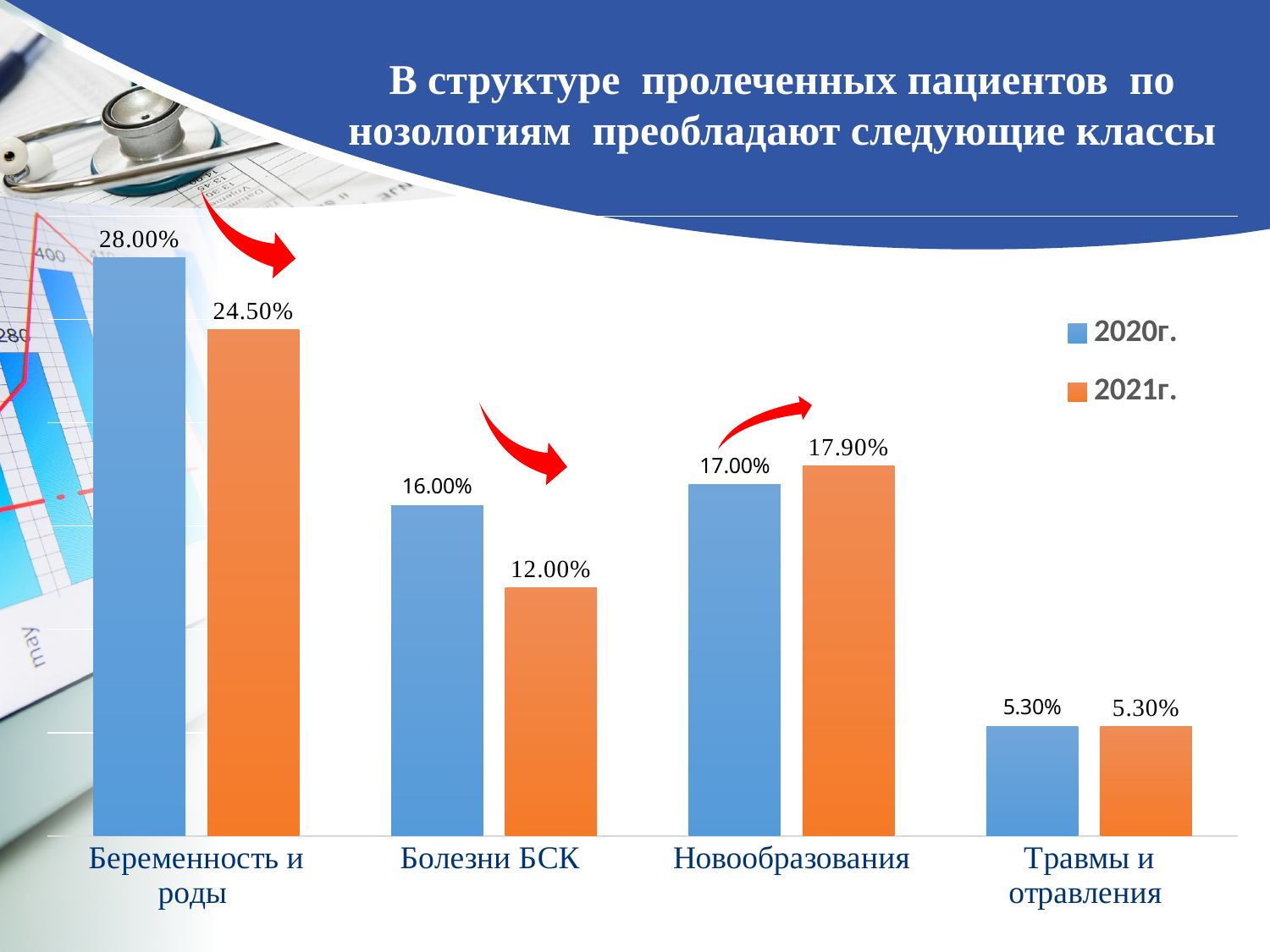
What is the value for Болезни БСК in 2021г.? 12.00% What is the difference between the 2020г. and 2021г. values for Болезни БСК? 4.00% Which is larger for Новообразования: the 2020г. value or the 2021г. value? 2021г. What is the value for Новообразования in 2021г.? 17.90% How many series does the legend list? 2 What kind of chart is shown on the slide? Bar chart What is the value for Беременность и роды in 2020г.? 28.00% Which category has the highest value in 2021г.? Беременность и роды Which colour represents the 2021г. series? Orange How many categories are shown on the x axis? 4 What is the value for Травмы и отравления in 2020г.? 5.30% Which category has the lowest value in 2020г.? Травмы и отравления